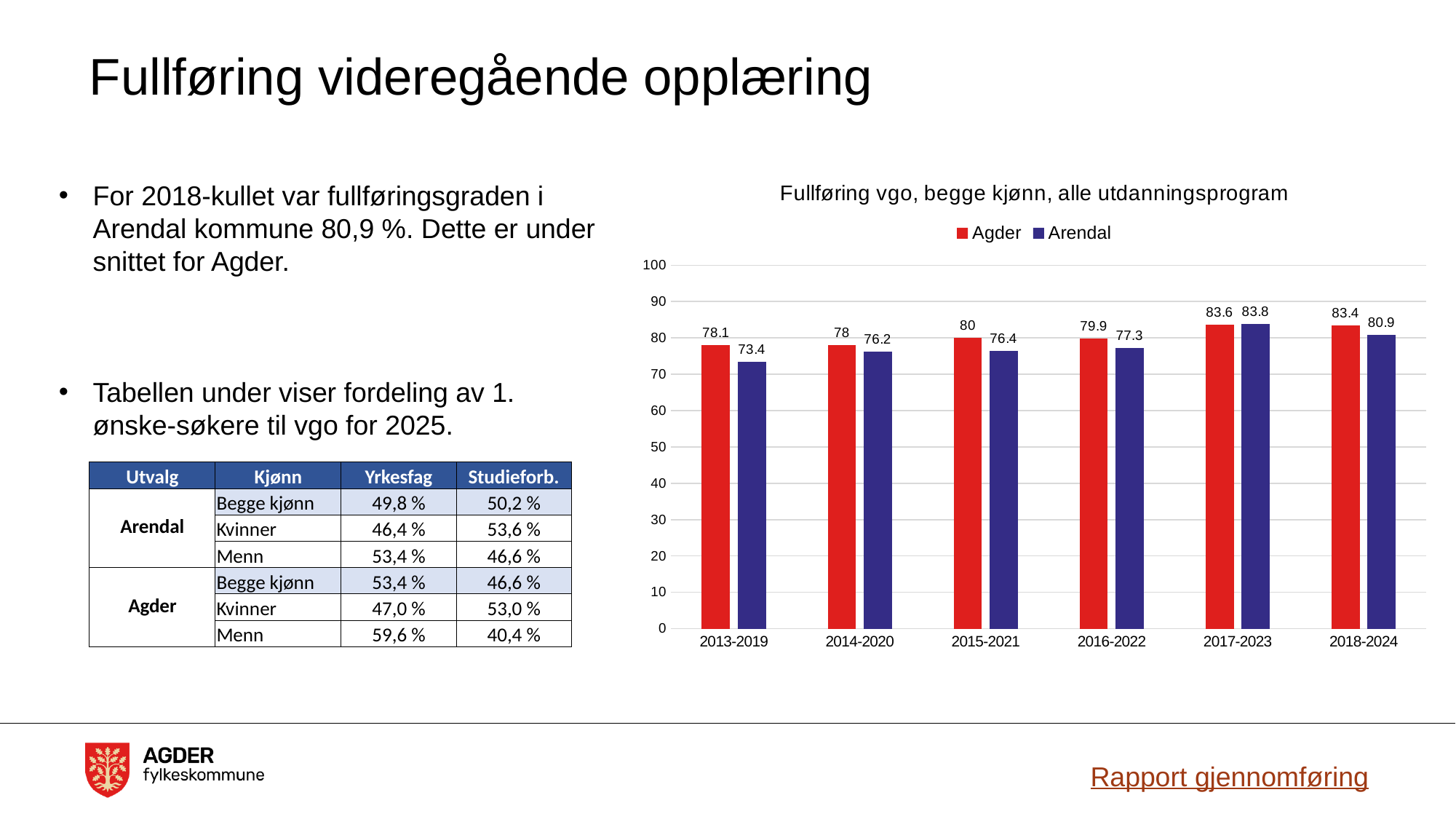
How many periods are shown on the x axis? 6 Is the value for Arendal in 2016-2022 greater or less than 80? less What kind of chart is shown? bar chart Which period has the highest value for Arendal? 2017-2023 What is the difference between Agder and Arendal in 2013-2019? 4.7 Which period has the lowest value for Agder? 2014-2020 What is the value for Arendal in 2013-2019? 73.4 What is the title of the chart? Fullføring vgo, begge kjønn, alle utdanningsprogram What is the value for Agder in 2015-2021? 80 How many series does the legend list? 2 Which is larger in 2018-2024, Agder or Arendal? Agder What is the value for Arendal in 2018-2024? 80.9